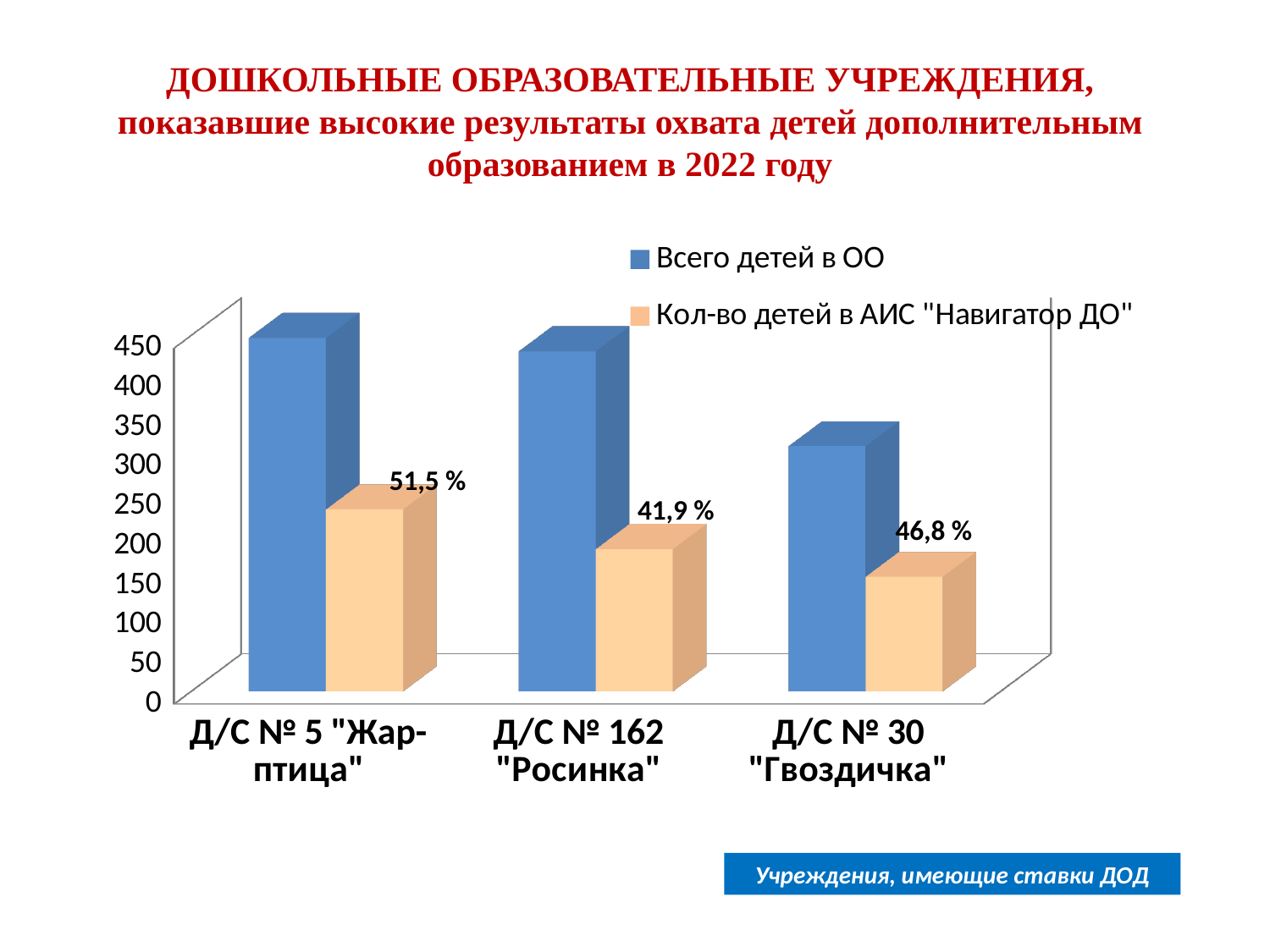
What percentage label is shown for Д/С № 5 "Жар-птица"? 51,5 % What percentage label is shown for Д/С № 30 "Гвоздичка"? 46,8 % What percentage label is shown for Д/С № 162 "Росинка"? 41,9 % How many preschool institutions (categories) are shown on the x axis? 3 What kind of chart is shown on the slide? bar chart Which institution has the lowest value for "Всего детей в ОО"? Д/С № 30 "Гвоздичка" Which institution has the highest percentage label? Д/С № 5 "Жар-птица" Is the value of "Всего детей в ОО" for Д/С № 30 "Гвоздичка" greater or less than 400? less What is the difference between the percentage labels for Д/С № 5 "Жар-птица" and Д/С № 162 "Росинка"? 9,6 % How many series does the legend list? 2 Which institution has the lowest percentage label? Д/С № 162 "Росинка" Which series is shown in blue in the legend? Всего детей в ОО